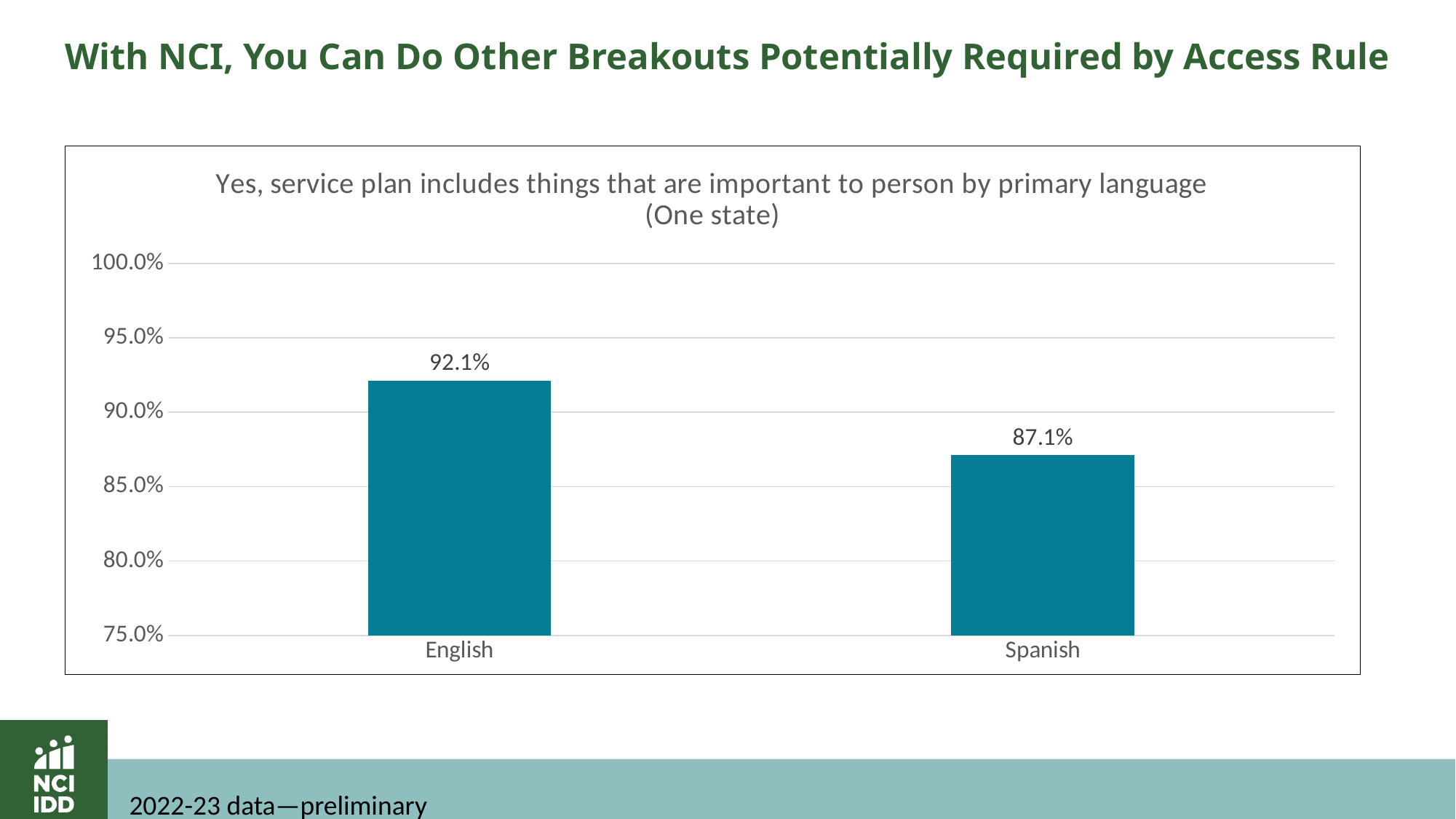
What is the difference between the values for English and Spanish? 5.0% What is the lowest value shown on the y axis? 75.0% What is the value for English? 92.1% Is the value for Spanish greater or less than 90.0%? less How many categories are shown on the x axis? 2 Which is larger, the value for English or the value for Spanish? English Which category has the lowest value? Spanish Do the values rise or fall from English to Spanish? fall Is the value for English greater or less than 90.0%? greater What kind of chart is shown on the slide? bar chart Which category has the highest value? English What is the value for Spanish? 87.1%